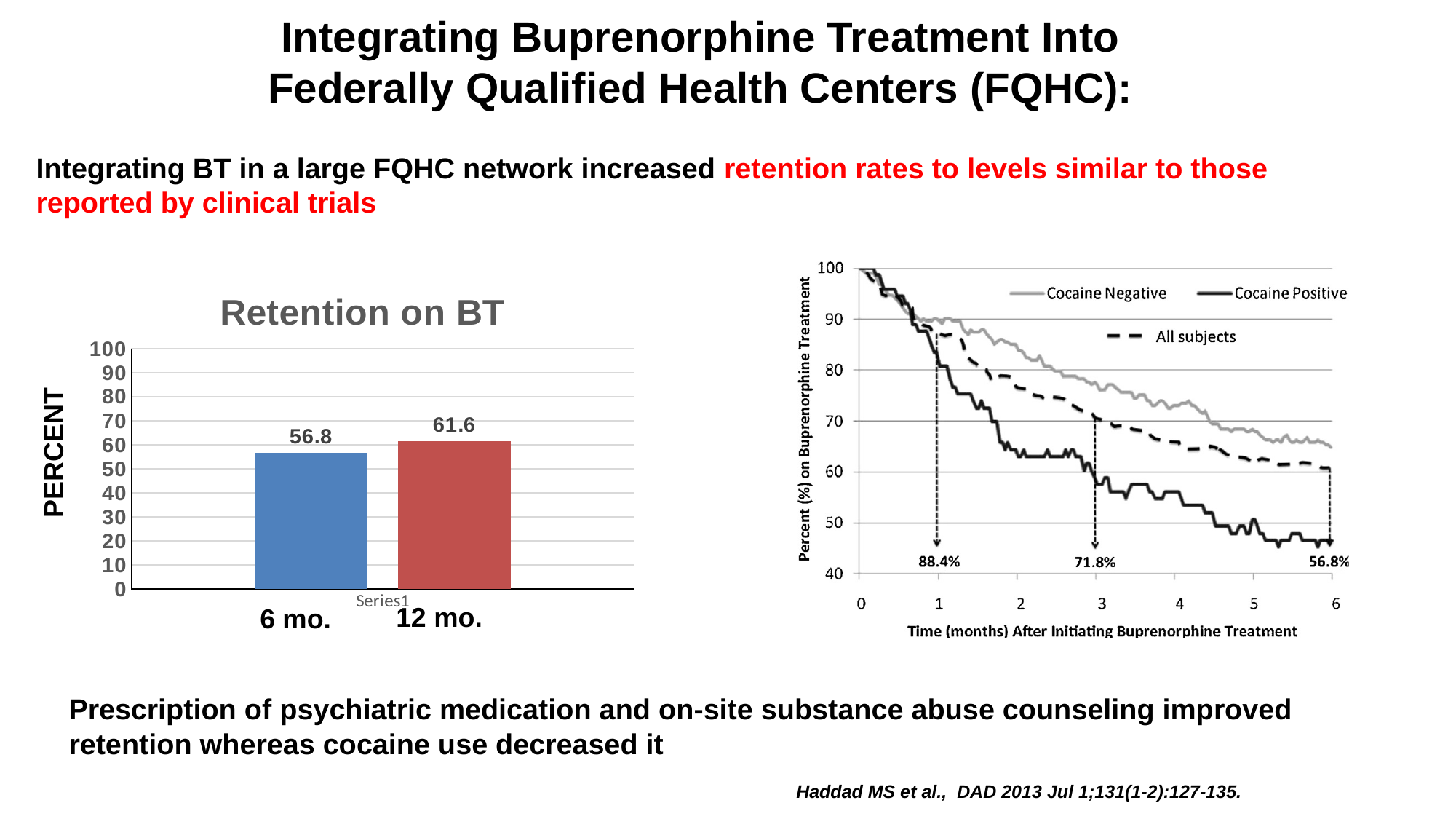
In the 'Retention on BT' chart, how many bars are plotted? 2 In the right-hand line chart, how many series does the legend list? 3 In the 'Retention on BT' chart, what is the label on the y axis? PERCENT In the 'Retention on BT' chart, what is the difference between the 12 mo. and 6 mo. values? 4.8 What kind of chart is the 'Retention on BT' chart? Bar chart In the right-hand line chart, what percentage is labelled at 1 month? 88.4% In the right-hand line chart, what percentage is labelled at 6 months? 56.8% In the 'Retention on BT' chart, which category has the higher value? 12 mo. In the right-hand line chart, do the lines rise or fall as time after initiating treatment increases? Fall In the right-hand line chart, what percentage is labelled at 3 months? 71.8% In the 'Retention on BT' chart, what is the value for 6 mo.? 56.8 In the 'Retention on BT' chart, what is the value for 12 mo.? 61.6